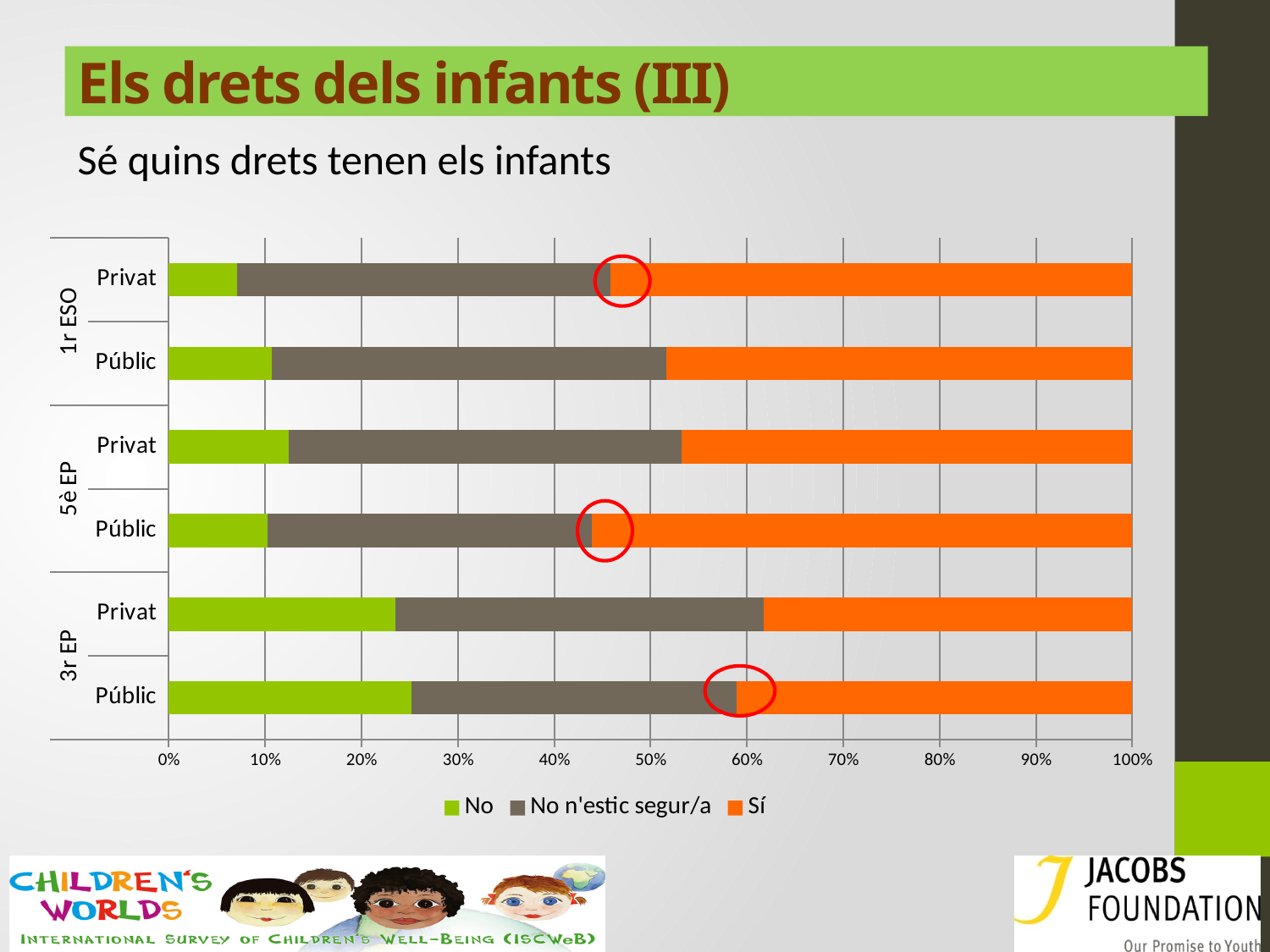
Is the "No" share for 3r EP Públic greater or less than 20%? greater Is the "Sí" share for 1r ESO Privat greater or less than 50%? greater Is the "No" share for 1r ESO Privat greater or less than 10%? less What kind of chart is shown on the slide? bar chart Which has a larger "Sí" share, 5è EP Públic or 3r EP Privat? 5è EP Públic Which has a larger "No" share, 3r EP Privat or 1r ESO Privat? 3r EP Privat What are the three legend entries of the chart? No, No n'estic segur/a, Sí How many series does the legend list? 3 Which bar has the smallest "No" share? 1r ESO Privat How many bars are plotted in the chart? 6 Which colour represents the "Sí" series in the chart? orange